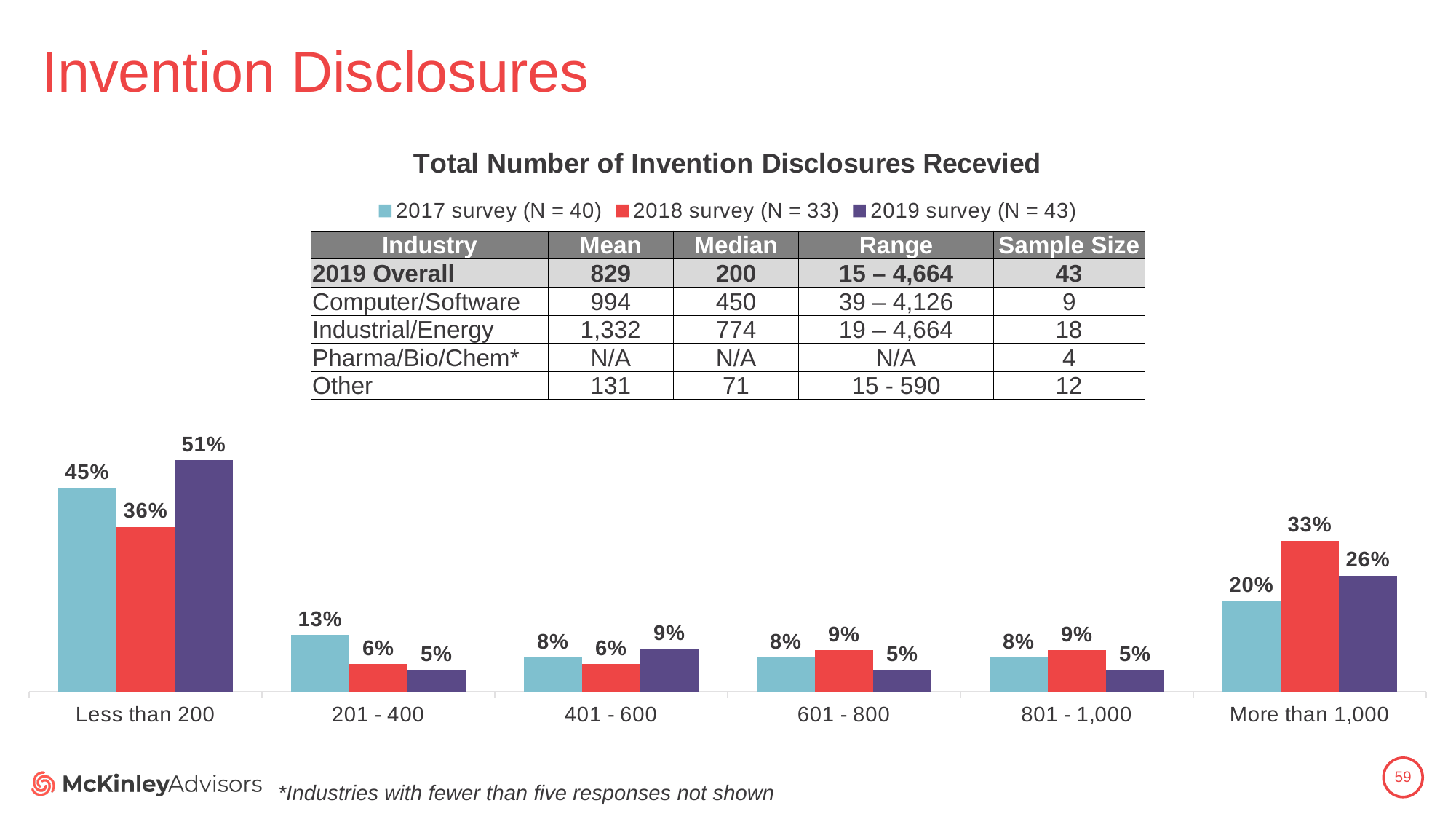
In the '601 - 800' category, which is larger: the 2018 survey value or the 2019 survey value? 2018 survey How many categories are shown on the x axis of the chart? 6 What kind of chart is shown on the slide? Bar chart How many series does the chart legend list? 3 Which category has the highest value for the 2017 survey? Less than 200 What is the value for the 2019 survey in the 'Less than 200' category? 51% What is the difference between the 2018 survey and 2019 survey values in the 'More than 1,000' category? 7% What is the value for the 2018 survey in the 'More than 1,000' category? 33% What is the difference between the 2019 survey and 2017 survey values in the 'Less than 200' category? 6% What is the sample size (N) for the 2019 survey according to the legend? 43 What is the value for the 2017 survey in the '201 - 400' category? 13% Which category has the lowest value for the 2018 survey? 201 - 400 and 401 - 600 (both 6%)